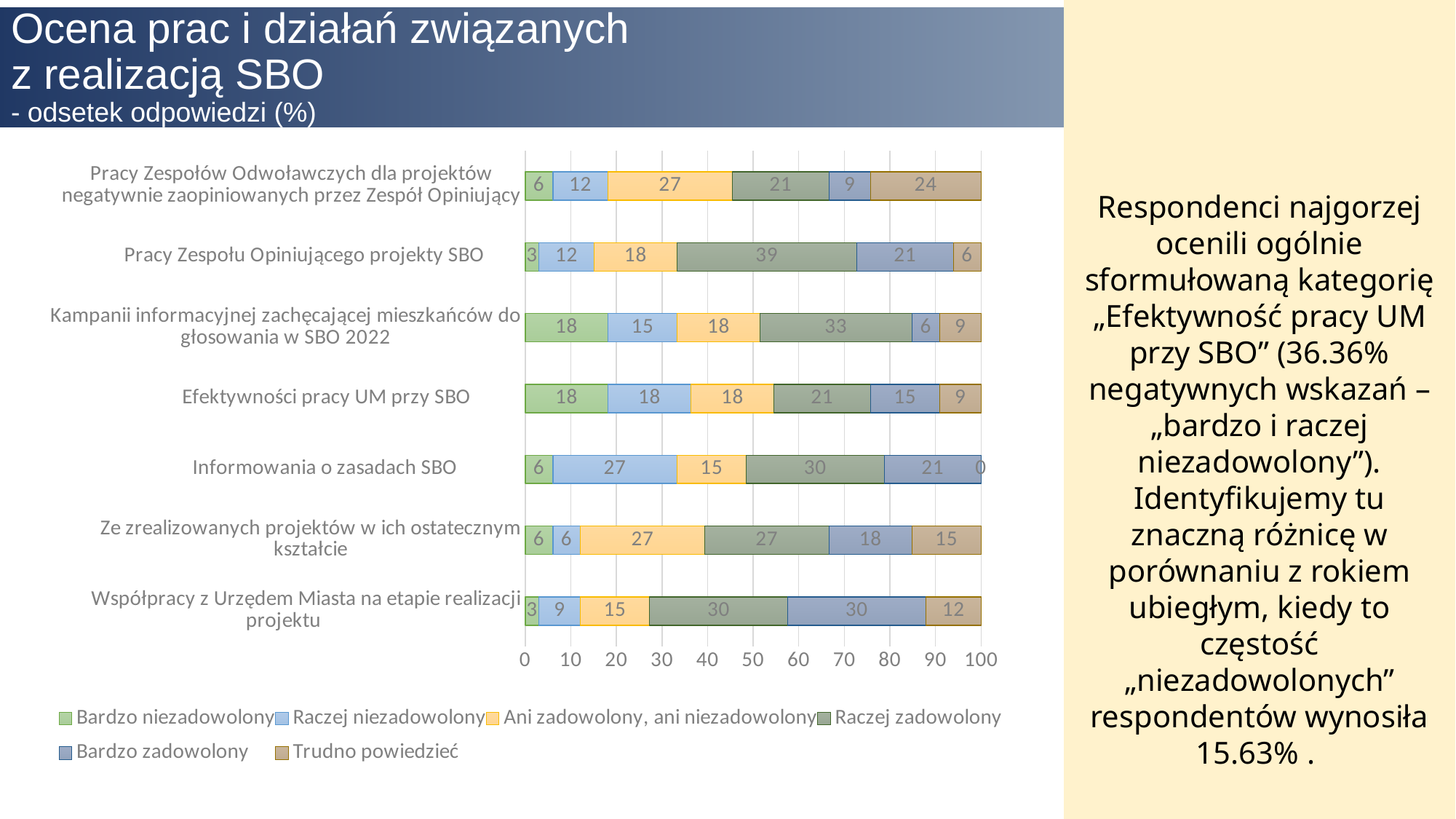
What is the difference between the "Raczej zadowolony" values for "Pracy Zespołu Opiniującego projekty SBO" and "Efektywności pracy UM przy SBO"? 18 What is the value of "Bardzo zadowolony" for "Współpracy z Urzędem Miasta na etapie realizacji projektu"? 30 What is the total of the stacked bar for "Efektywności pracy UM przy SBO"? 99 What type of chart is shown on the slide? stacked bar chart What is the value of "Raczej zadowolony" for "Pracy Zespołu Opiniującego projekty SBO"? 39 How many series does the legend list? 6 What is the value of "Bardzo niezadowolony" for "Efektywności pracy UM przy SBO"? 18 What is the value of "Trudno powiedzieć" for "Pracy Zespołów Odwoławczych dla projektów negatywnie zaopiniowanych przez Zespół Opiniujący"? 24 How many categories are plotted on the chart? 7 Which category has the highest value for "Raczej zadowolony"? Pracy Zespołu Opiniującego projekty SBO Which category has the lowest value for "Bardzo zadowolony"? Kampanii informacyjnej zachęcającej mieszkańców do głosowania w SBO 2022 Which is larger: the "Raczej niezadowolony" value for "Informowania o zasadach SBO" or for "Ze zrealizowanych projektów w ich ostatecznym kształcie"? Informowania o zasadach SBO